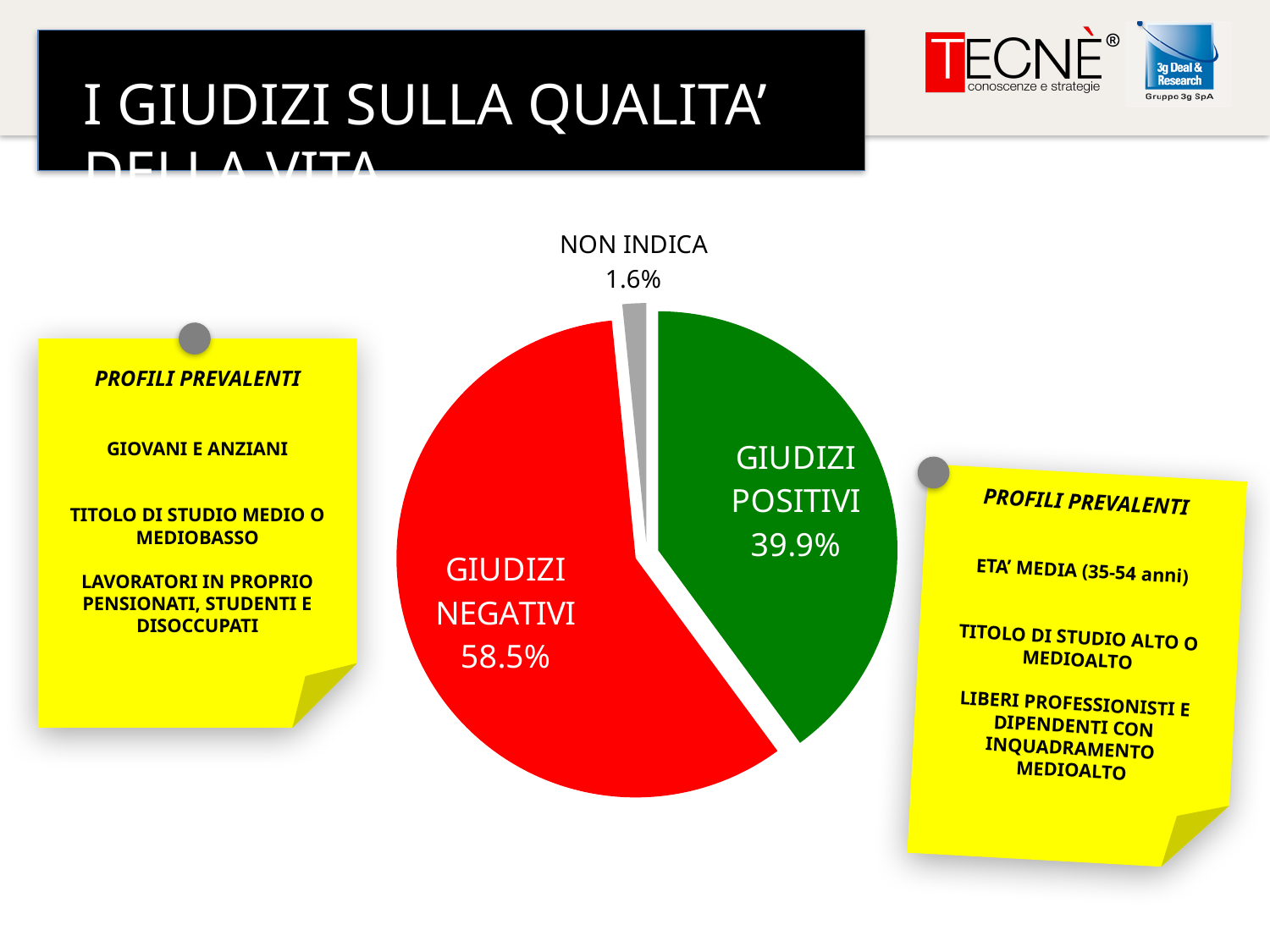
What is the combined share of GIUDIZI POSITIVI and NON INDICA? 41.5% What is the difference in percentage points between GIUDIZI NEGATIVI and GIUDIZI POSITIVI? 18.6 What percentage of the pie is NON INDICA? 1.6% Which is larger, GIUDIZI POSITIVI or GIUDIZI NEGATIVI? GIUDIZI NEGATIVI What percentage of the pie is GIUDIZI POSITIVI? 39.9% What colour is the GIUDIZI POSITIVI slice? green Which slice of the pie is the smallest? NON INDICA What percentage of the pie is GIUDIZI NEGATIVI? 58.5% What colour is the GIUDIZI NEGATIVI slice? red What kind of chart is shown on the slide? pie chart Which slice of the pie is the largest? GIUDIZI NEGATIVI How many slices does the pie chart have? 3